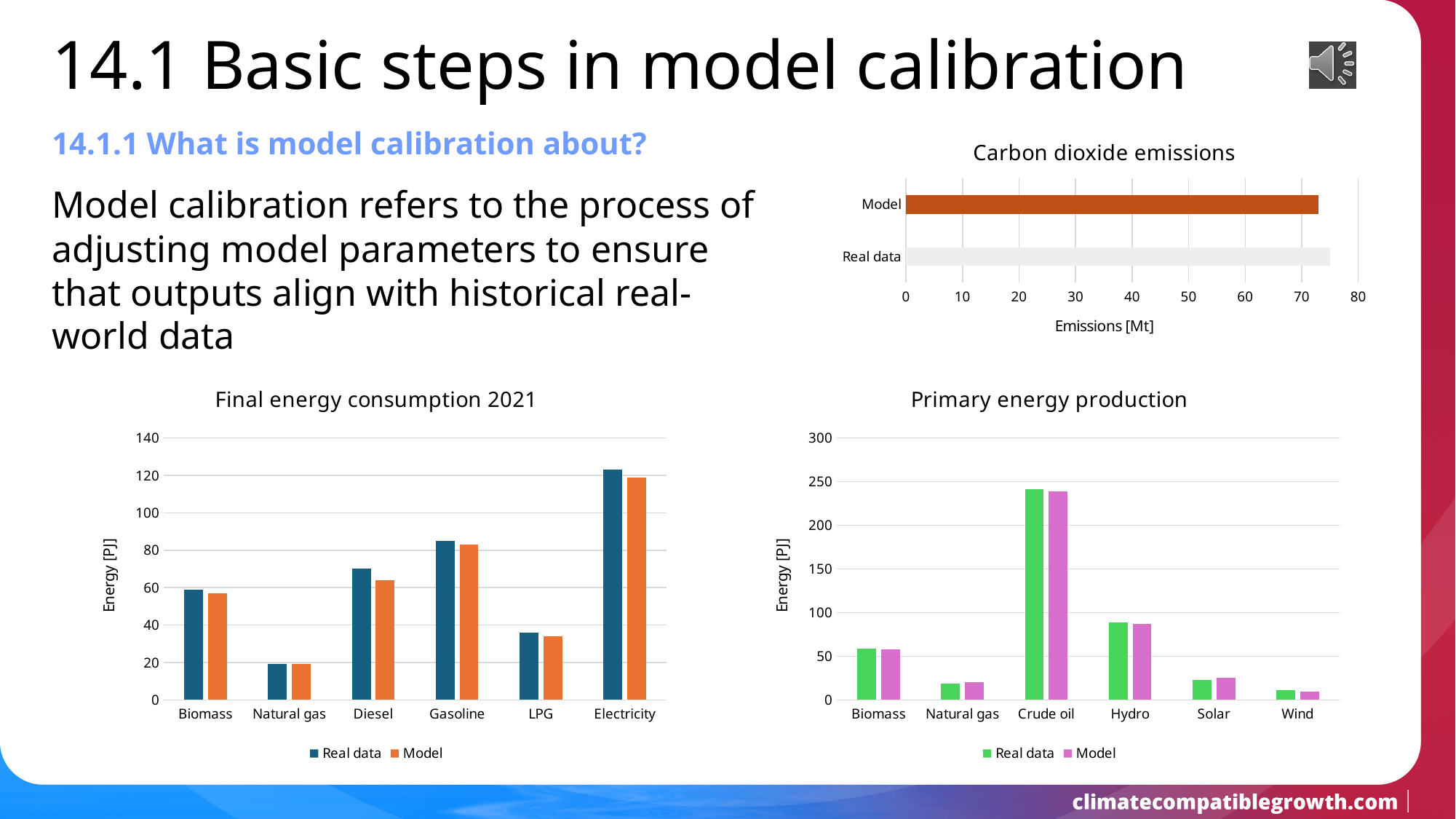
In the 'Primary energy production' chart, is the Real data value for Hydro greater or less than 100? less In the 'Final energy consumption 2021' chart, which is larger for Diesel: the Real data value or the Model value? Real data In the 'Primary energy production' chart, which is larger: the Real data value for Biomass or the Real data value for Solar? Biomass In the 'Final energy consumption 2021' chart, which category has the highest Real data value? Electricity In the 'Final energy consumption 2021' chart, is the Real data value for Electricity greater or less than 120? greater What is the x-axis label of the 'Carbon dioxide emissions' chart? Emissions [Mt] How many categories are shown on the x axis of the 'Primary energy production' chart? 6 In the 'Carbon dioxide emissions' chart, is the Model value greater or less than 70? greater How many series does the legend of the 'Final energy consumption 2021' chart list? 2 In the 'Primary energy production' chart, which category has the highest Real data value? Crude oil What kind of chart is the 'Final energy consumption 2021' chart? bar chart In the 'Primary energy production' chart, which category has the lowest Model value? Wind